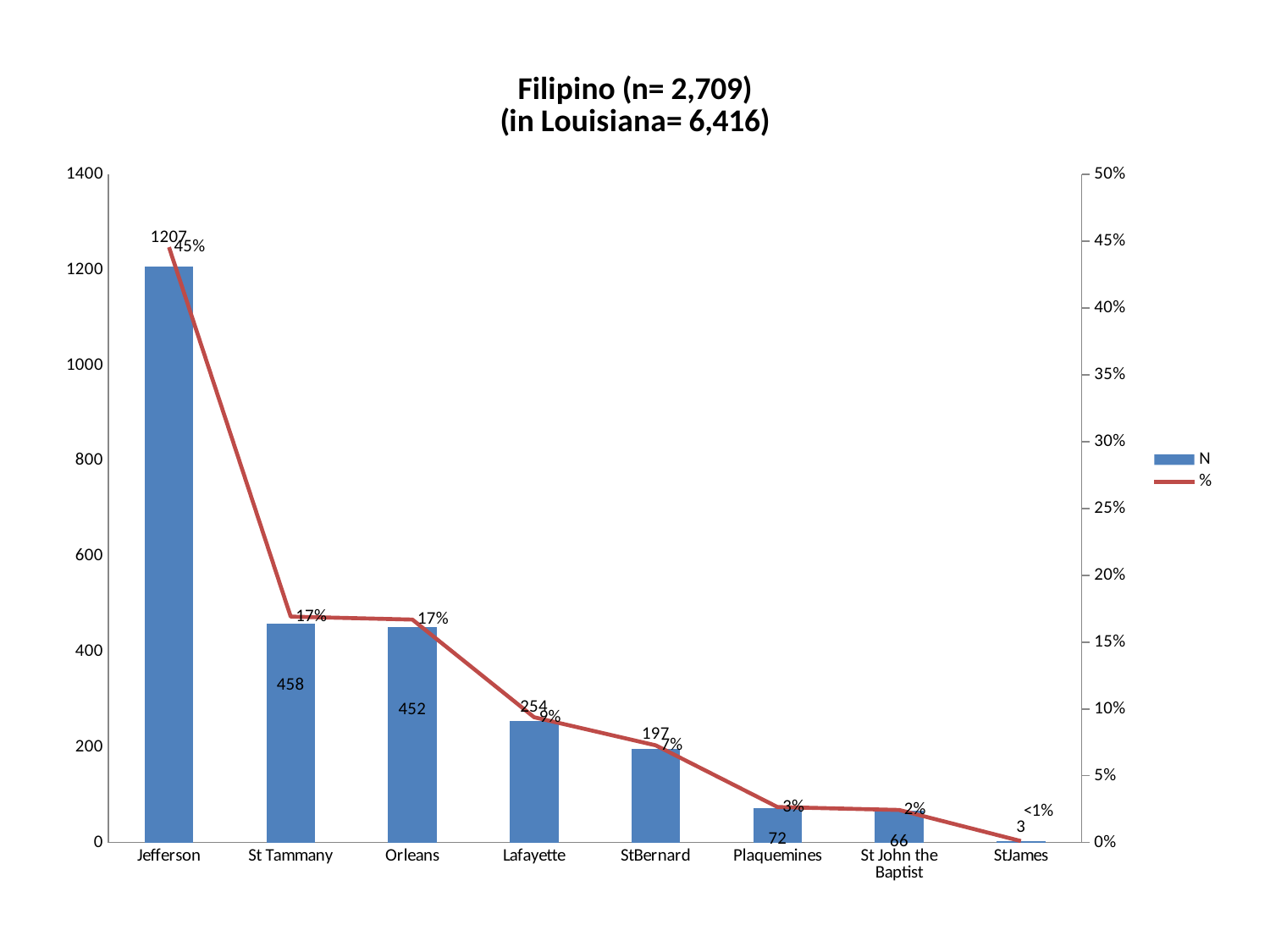
What is the difference between the N values for Jefferson and St Tammany? 749 What is the N value for Lafayette? 254 What kind of chart is used for the N series? Bar chart How many series does the legend list? 2 How many parishes are shown on the x axis? 8 Do the N values rise or fall from left to right along the x axis? Fall Which parish has the lowest N value? StJames Which parish has the highest N value? Jefferson What is the N value for Jefferson? 1207 Which has a larger N value, Plaquemines or St John the Baptist? Plaquemines What percentage is shown for Orleans? 17% What percentage is shown for StBernard? 7%